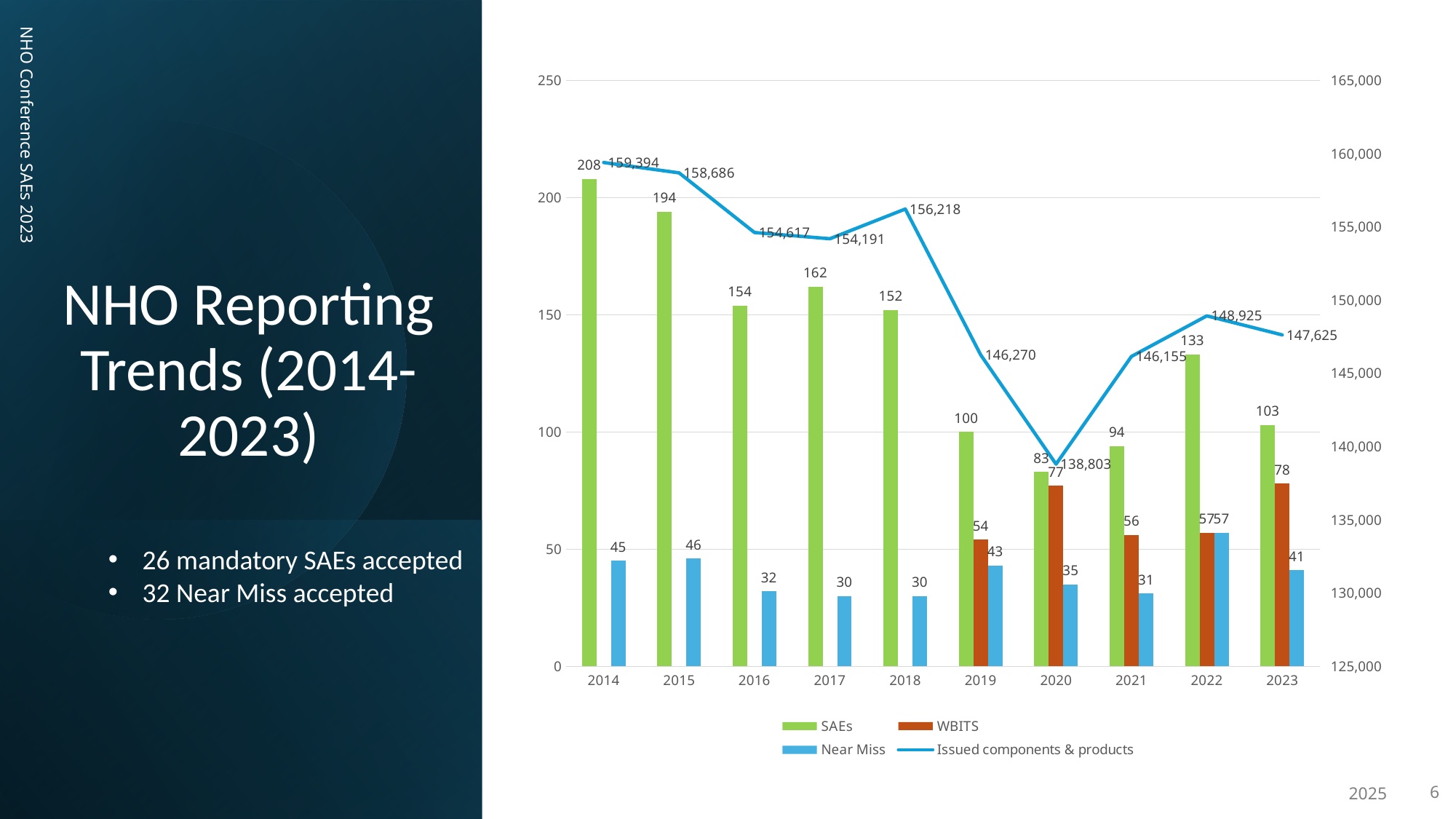
What is the difference between the SAEs values for 2014 and 2015? 14 Which year has the highest SAEs value? 2014 How many years are shown on the x axis? 10 What is the WBITS value for 2023? 78 Which series is plotted as a line? Issued components & products How many series does the legend list? 4 What is the SAEs value for 2014? 208 What is the Near Miss value for 2019? 43 Which year has the lowest Issued components & products value? 2020 What kind of chart is shown on the slide? Combined bar and line chart What is the Issued components & products value for 2020? 138,803 Which is larger, the WBITS value for 2020 or the WBITS value for 2021? 2020